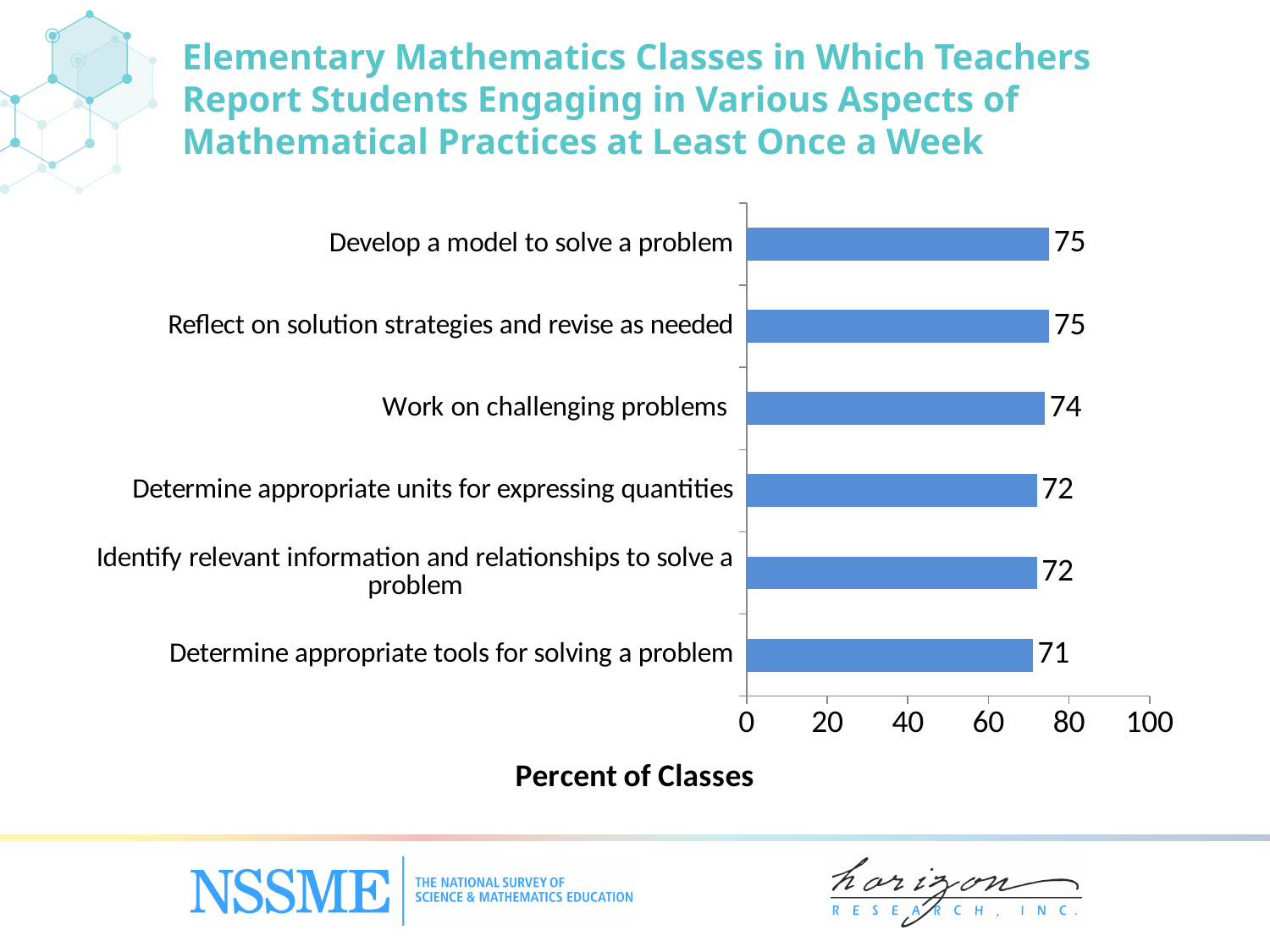
Which is larger: the value for "Reflect on solution strategies and revise as needed" or the value for "Determine appropriate tools for solving a problem"? Reflect on solution strategies and revise as needed What percent of classes is reported for "Work on challenging problems"? 74 What is the difference between the values for "Work on challenging problems" and "Identify relevant information and relationships to solve a problem"? 2 Which category has the lowest value? Determine appropriate tools for solving a problem What is the value for "Develop a model to solve a problem"? 75 What is the value for "Determine appropriate units for expressing quantities"? 72 What is the value for "Determine appropriate tools for solving a problem"? 71 Is the value for "Work on challenging problems" greater or less than 60? greater What is the difference between the values for "Develop a model to solve a problem" and "Determine appropriate tools for solving a problem"? 4 What is the label of the horizontal axis? Percent of Classes What kind of chart is shown on the slide? bar chart How many categories are shown in the chart? 6